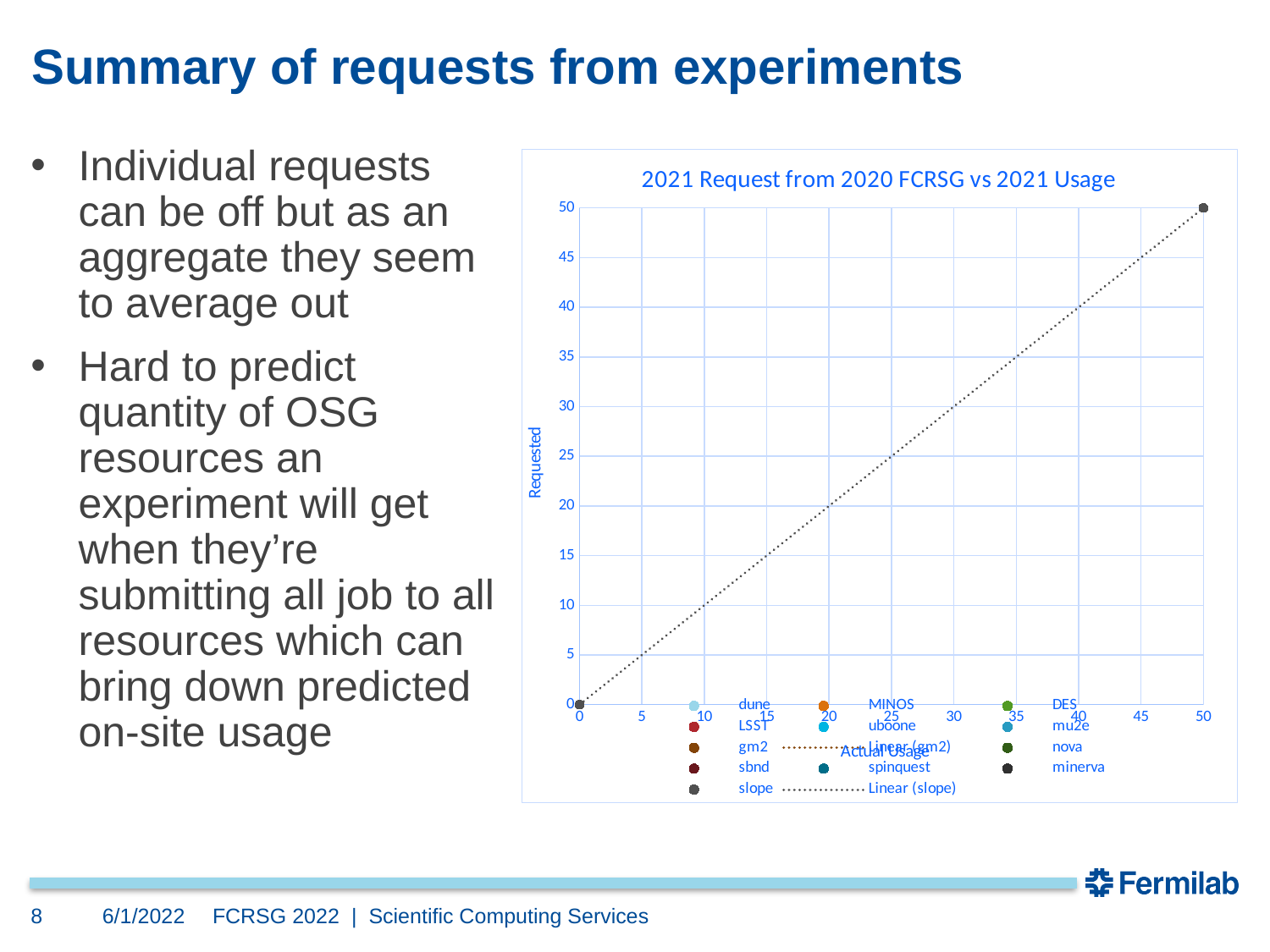
Does the dotted Linear (slope) line rise or fall as Actual Usage increases? rise How many entries does the chart's legend list? 14 What is the title of the chart? 2021 Request from 2020 FCRSG vs 2021 Usage What kind of chart is shown on the slide? scatter chart What is the Actual Usage value of the point at the top right end of the dotted line? 50 Is the Requested value of the point at the far right of the dotted line greater or less than 40? greater What is the label of the vertical axis of the chart? Requested What is the highest value shown on the vertical axis of the chart? 50 What is the Requested value of the point at the top right end of the dotted line? 50 Is the Requested value of the point at the bottom left of the dotted line greater or less than 5? less